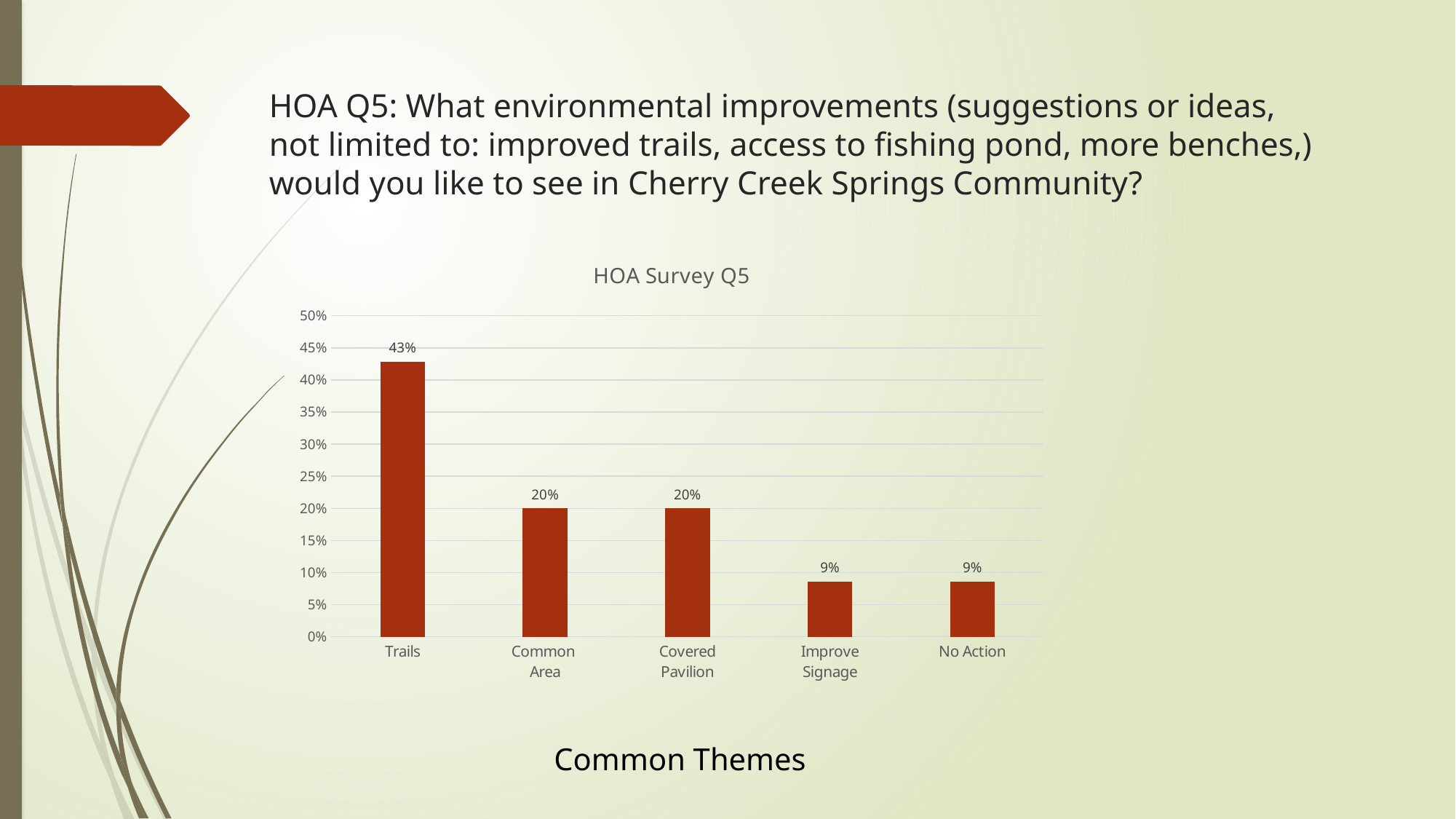
Is the value for Trails greater or less than 40%? greater Which is larger, the value for Trails or the value for Common Area? Trails What is the difference between the values for Common Area and Improve Signage? 11% What is the title of the chart? HOA Survey Q5 What is the value for No Action? 9% What is the value for Trails? 43% What is the value for Common Area? 20% How many categories are shown on the x axis? 5 Which category has the highest value? Trails What is the difference between the values for Trails and Covered Pavilion? 23% What kind of chart is shown on the slide? bar chart What is the value for Improve Signage? 9%